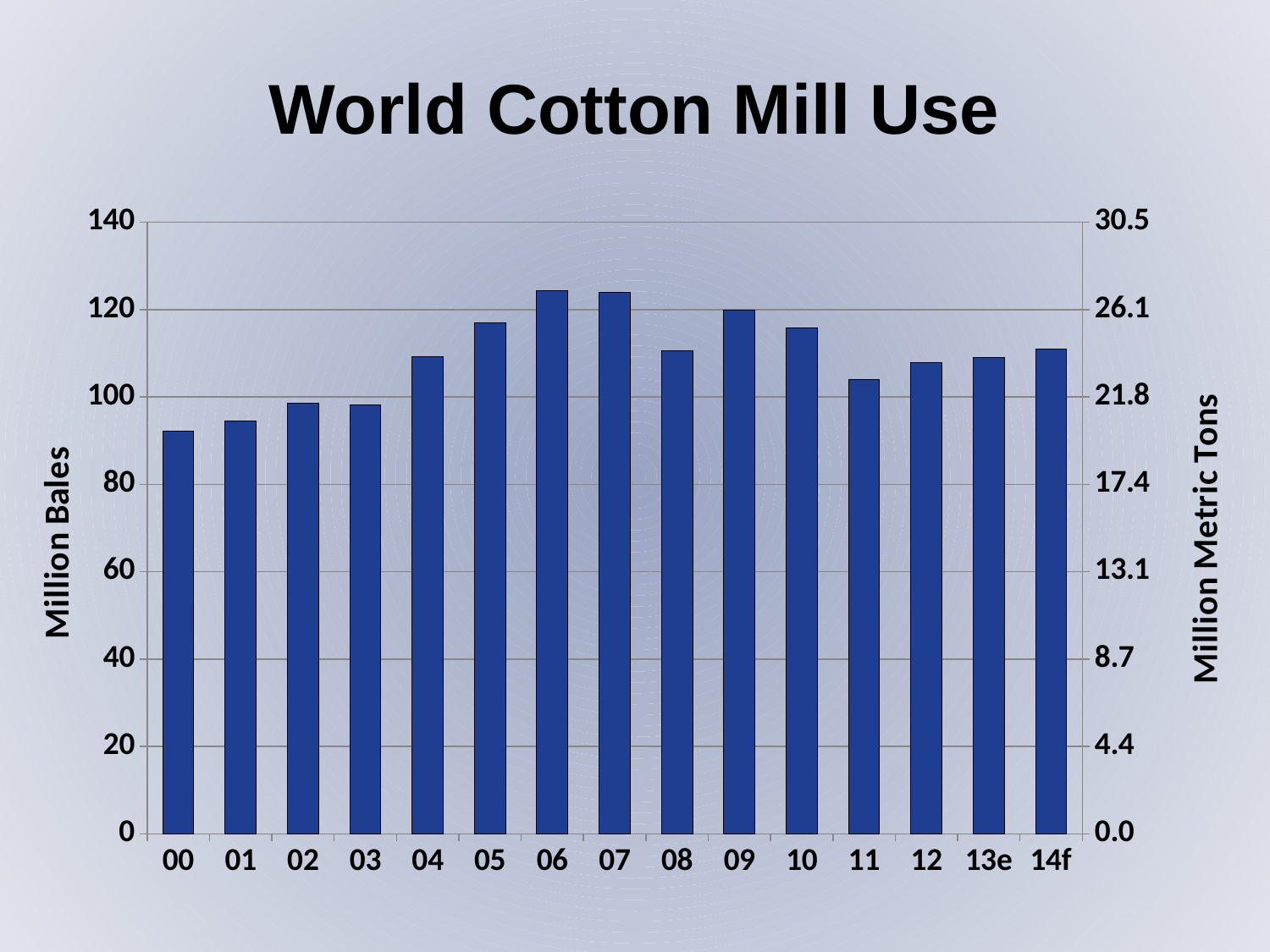
What is the label of the left vertical axis? Million Bales Which year has the lowest world cotton mill use? 00 Do the values rise or fall from 00 to 06? rise Is the value for 10 greater or less than 120 million bales? less Which is larger, the value for 05 or the value for 08? 05 How many years (bars) are shown on the x axis? 15 Is the value for 11 greater or less than 100 million bales? greater Is the value for 00 greater or less than 100 million bales? less What is the title of the chart? World Cotton Mill Use What kind of chart is shown on the slide? bar chart Which is larger, the value for 09 or the value for 11? 09